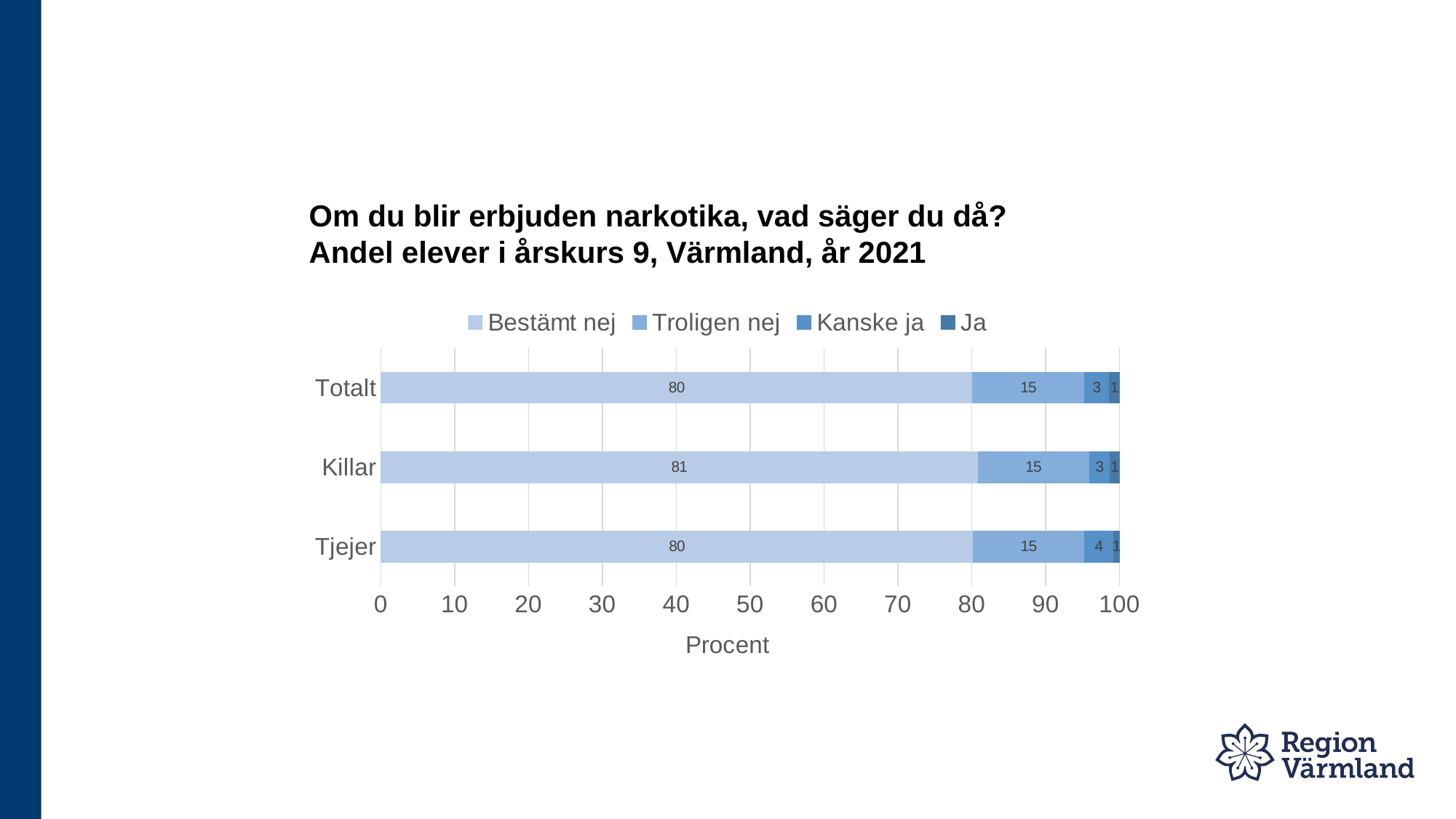
What is the value of Troligen nej for Totalt? 15 What is the difference between the Bestämt nej values for Killar and Tjejer? 1 Which category has the highest value for Bestämt nej? Killar How many categories are shown on the vertical axis? 3 What is the value of Kanske ja for Tjejer? 4 How many series does the legend list? 4 Which category has the highest value for Kanske ja? Tjejer What is the value of Bestämt nej for Killar? 81 What type of chart is shown on the slide? Stacked bar chart What is the total of the stacked bar for Totalt? 99 What is the label of the horizontal axis? Procent What is the value of Ja for Killar? 1